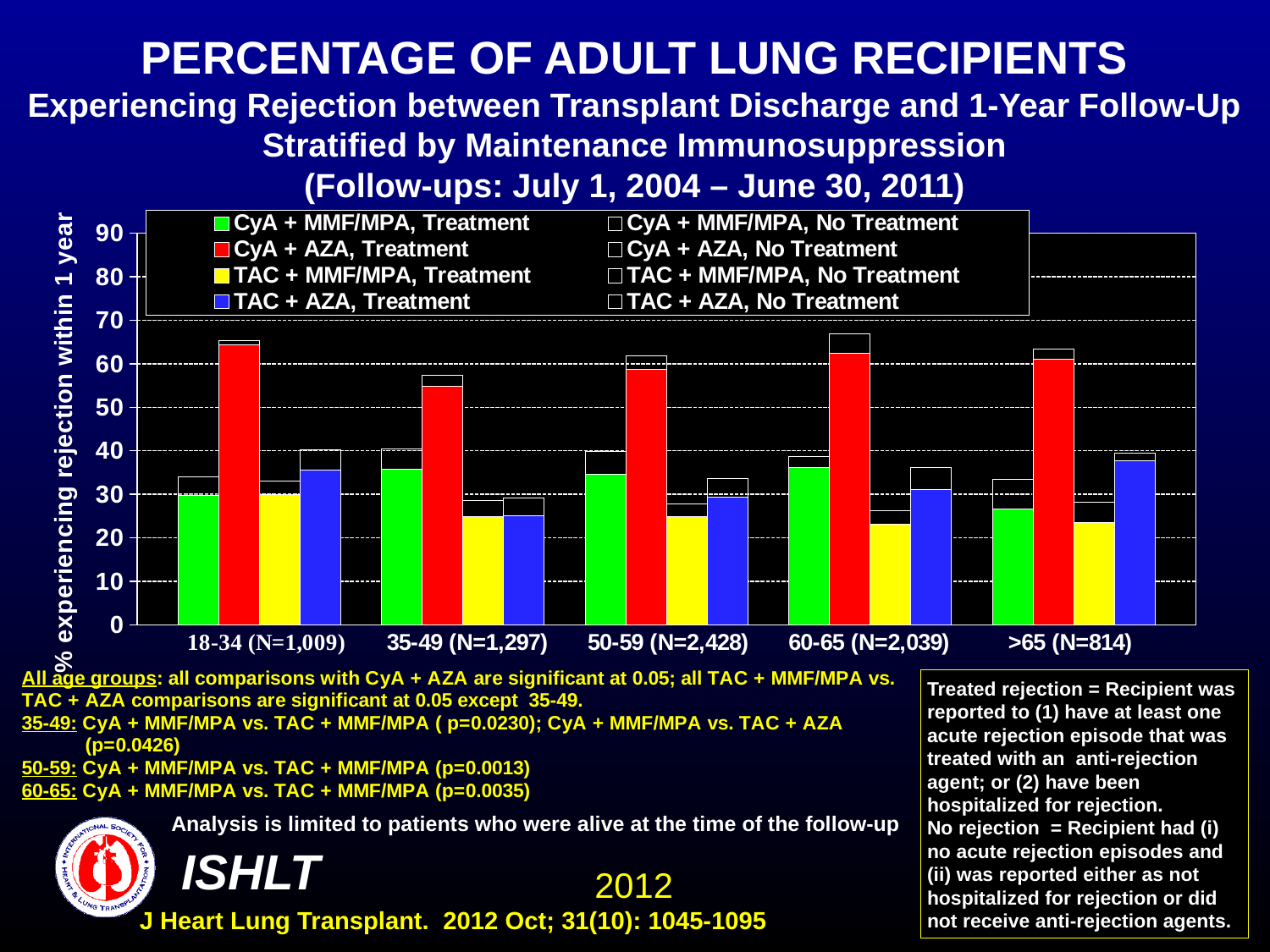
Is the CyA + AZA, Treatment value for the 35-49 age group greater or less than 50? greater Is the CyA + AZA, Treatment value for the 18-34 age group greater or less than 60? greater What kind of chart is shown on the slide? bar chart What is the N shown for the 50-59 age group on the x axis? N=2,428 In the 18-34 age group, which immunosuppression regimen has the highest treated rejection bar? CyA + AZA Is the CyA + MMF/MPA, Treatment value for the 18-34 age group greater or less than 40? less In the 60-65 age group, which immunosuppression regimen has the lowest treated rejection bar? TAC + MMF/MPA How many age groups are shown along the x axis of the chart? 5 How many series does the chart's legend list? 8 In the >65 age group, which is larger: the TAC + AZA, Treatment value or the CyA + MMF/MPA, Treatment value? TAC + AZA, Treatment